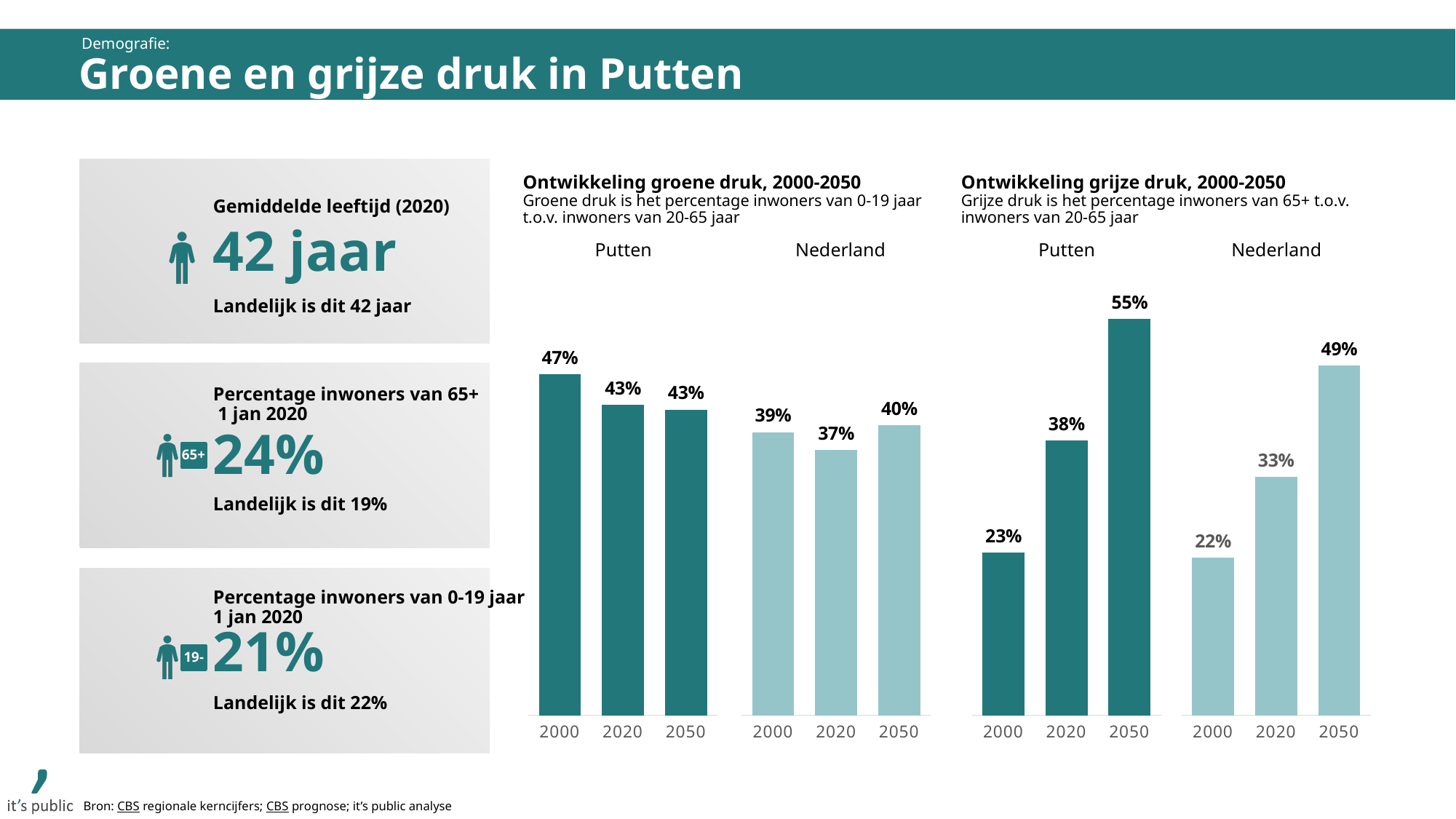
In the 'Ontwikkeling grijze druk, 2000-2050' chart, which bar is the highest? Putten 2050 In the 'Ontwikkeling grijze druk, 2000-2050' chart, which is larger: Putten in 2020 or Nederland in 2020? Putten in 2020 In the 'Ontwikkeling groene druk, 2000-2050' chart, what is the value for Nederland in 2020? 37% In the 'Ontwikkeling groene druk, 2000-2050' chart, what is the difference between Putten and Nederland in 2050? 3 percentage points In the 'Ontwikkeling groene druk, 2000-2050' chart, which bar is the lowest? Nederland 2020 What kind of chart is 'Ontwikkeling grijze druk, 2000-2050'? bar chart In the 'Ontwikkeling grijze druk, 2000-2050' chart, what is the value for Nederland in 2000? 22% In the 'Ontwikkeling grijze druk, 2000-2050' chart, do the values for Putten rise or fall from 2000 to 2050? rise In the 'Ontwikkeling groene druk, 2000-2050' chart, what is the value for Putten in 2000? 47% How many bars are shown in the 'Ontwikkeling groene druk, 2000-2050' chart? 6 In the 'Ontwikkeling grijze druk, 2000-2050' chart, what is the difference between Putten in 2050 and Putten in 2000? 32 percentage points In the 'Ontwikkeling grijze druk, 2000-2050' chart, what is the value for Putten in 2050? 55%